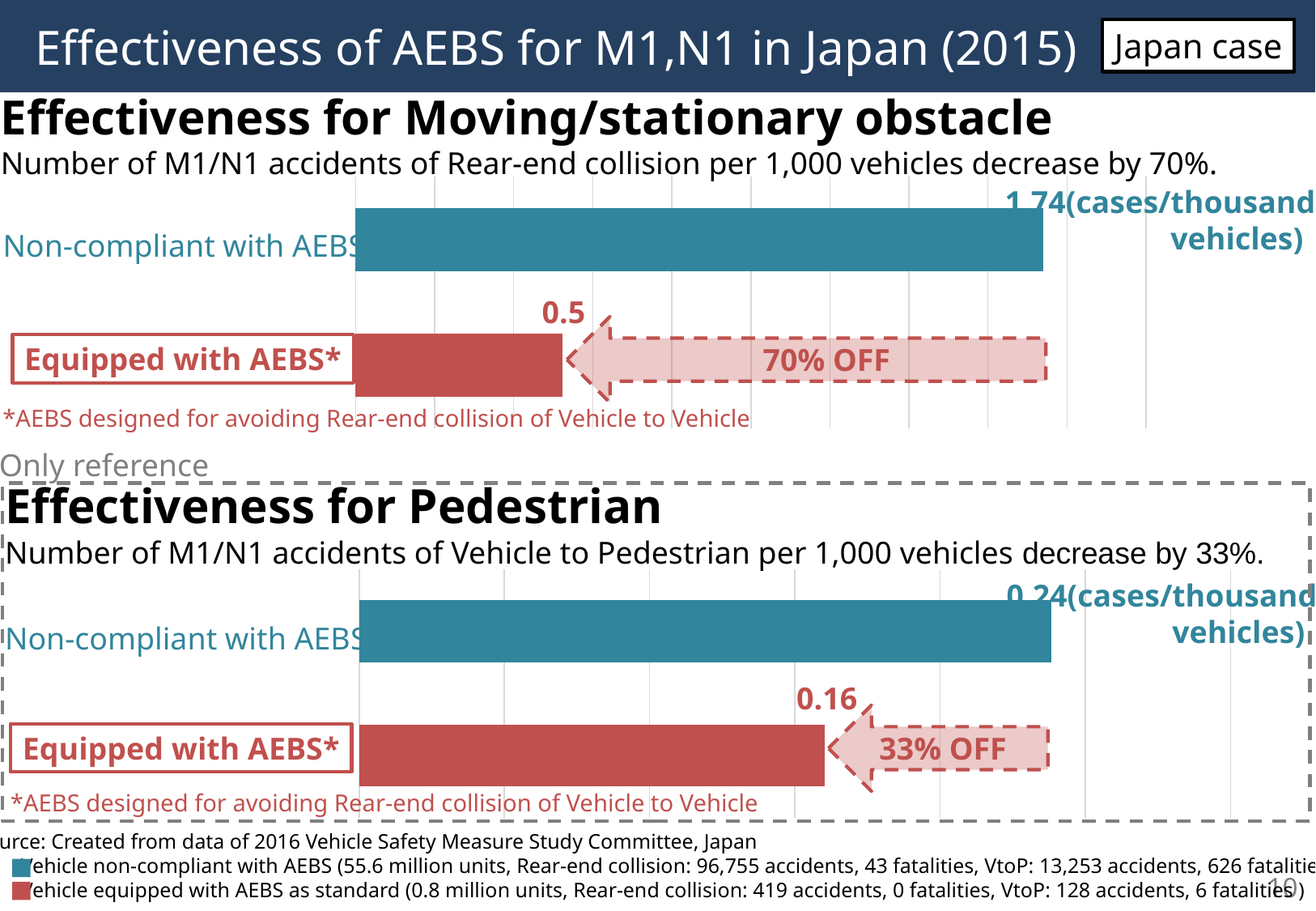
What type of chart is the 'Effectiveness for Pedestrian' chart? bar chart In the 'Effectiveness for Pedestrian' chart, is the value for Non-compliant with AEBS larger or smaller than the value for Equipped with AEBS*? larger In the 'Effectiveness for Moving/stationary obstacle' chart, what percentage reduction is shown by the arrow label? 70% OFF In the 'Effectiveness for Pedestrian' chart, what is the difference between the Non-compliant with AEBS value and the Equipped with AEBS* value? 0.08 In the 'Effectiveness for Moving/stationary obstacle' chart, which category has the higher value? Non-compliant with AEBS In the 'Effectiveness for Pedestrian' chart, which category has the lower value? Equipped with AEBS* In the 'Effectiveness for Moving/stationary obstacle' chart, what is the difference between the Non-compliant with AEBS value and the Equipped with AEBS* value? 1.24 In the 'Effectiveness for Pedestrian' chart, what is the value for Non-compliant with AEBS? 0.24 In the 'Effectiveness for Pedestrian' chart, what is the value for Equipped with AEBS*? 0.16 How many categories are shown in the 'Effectiveness for Moving/stationary obstacle' chart? 2 In the 'Effectiveness for Moving/stationary obstacle' chart, what is the value for Equipped with AEBS*? 0.5 In the 'Effectiveness for Moving/stationary obstacle' chart, what is the value for Non-compliant with AEBS? 1.74